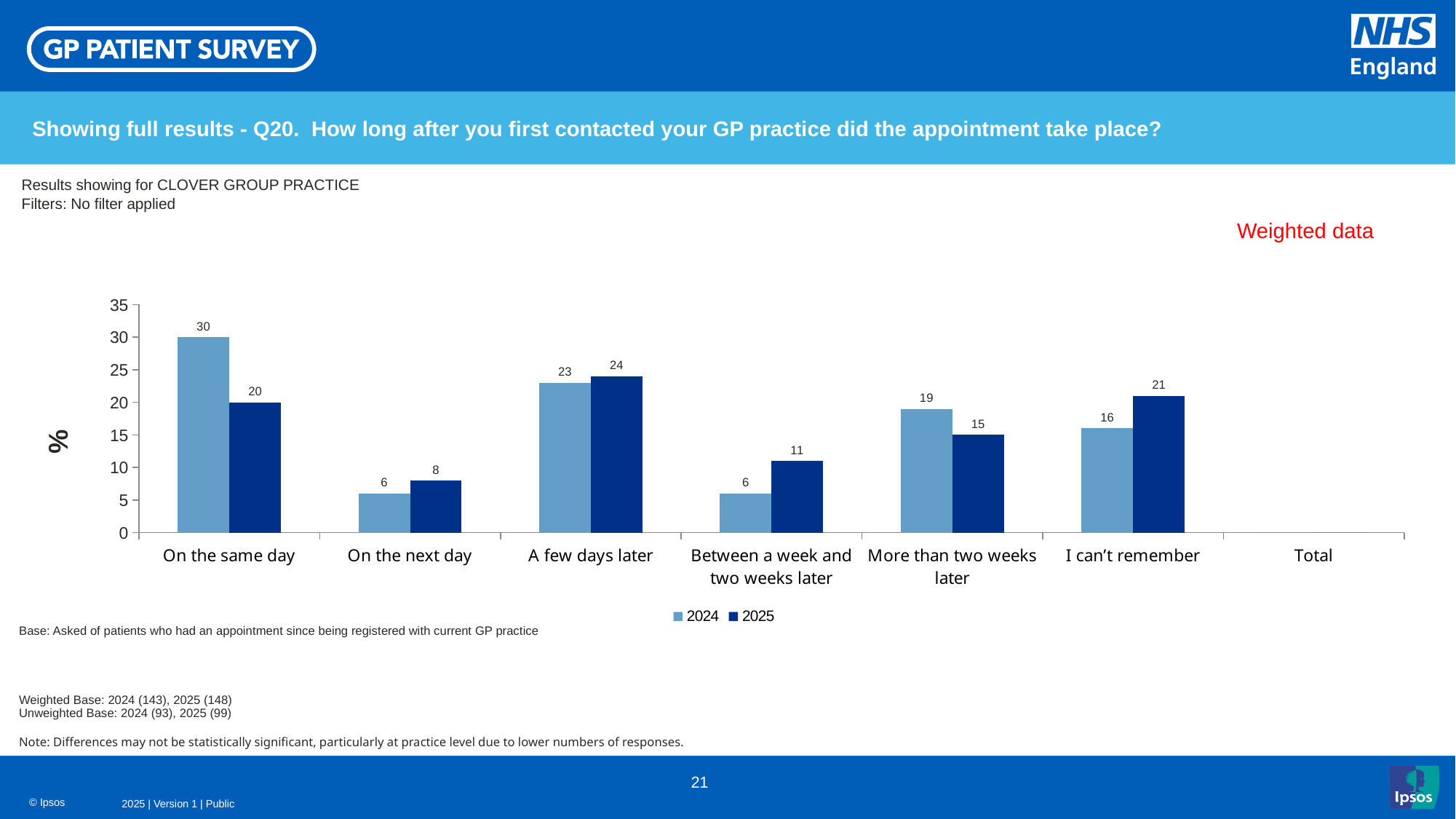
What is the 2025 value for 'I can't remember'? 21 What label is shown on the vertical axis of the chart? % Which category has the highest 2024 value? On the same day How many series does the legend list? 2 What is the difference between the 2024 and 2025 values for 'On the same day'? 10 Is the 2025 value for 'A few days later' greater or less than 20? greater Which category has the lowest 2025 value? On the next day Which is larger for 'More than two weeks later': the 2024 value or the 2025 value? 2024 What kind of chart is shown on the slide? Bar chart What is the 2025 value for 'Between a week and two weeks later'? 11 What is the 2024 value for 'On the same day'? 30 What is the difference between the 2024 and 2025 values for 'Between a week and two weeks later'? 5